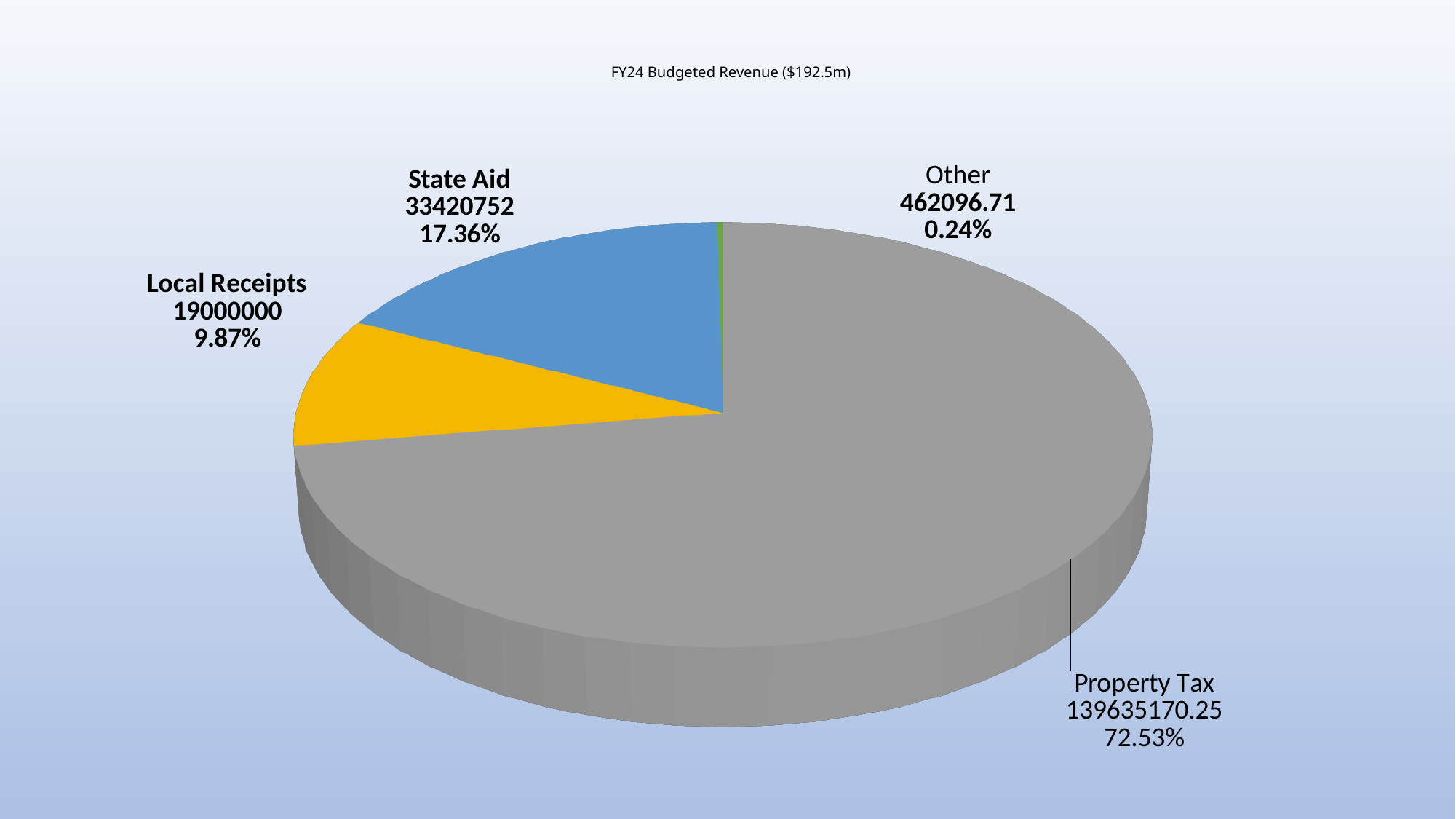
What is the value for Local Receipts? 19000000 What is the title of the pie chart? FY24 Budgeted Revenue ($192.5m) What is the value for Other? 462096.71 What is the value for State Aid? 33420752 What kind of chart is shown on the slide? pie chart What share of the pie does State Aid represent? 17.36% Which category has the largest slice of the pie? Property Tax Which is larger, Local Receipts or State Aid? State Aid How many slices does the pie chart have? 4 Which category has the smallest slice of the pie? Other What is the difference between the State Aid and Local Receipts values? 14420752 What is the value for Property Tax? 139635170.25